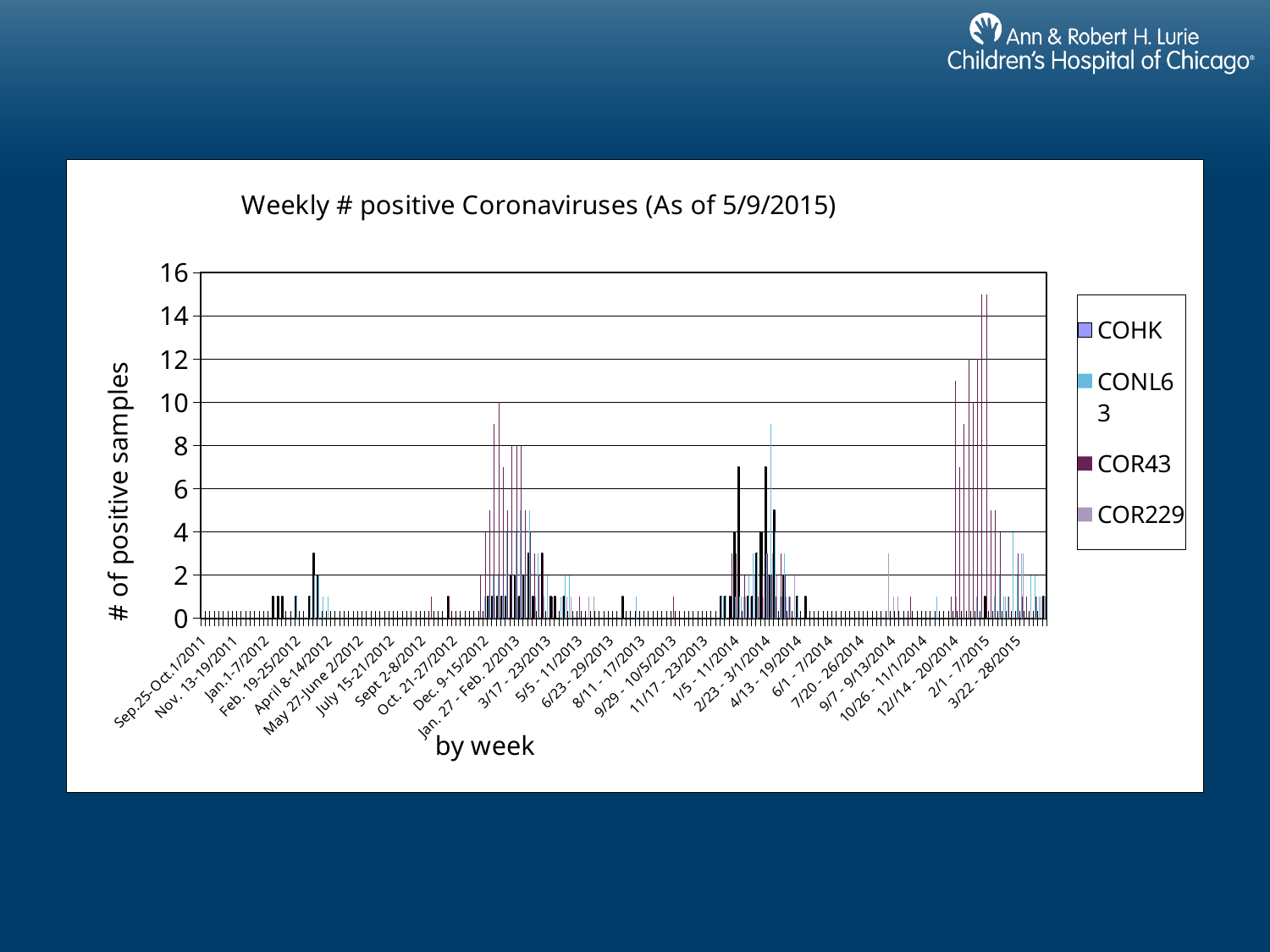
Is the tallest bar in the chart greater or less than 16? less Is the tallest bar in the cluster around 1/5 - 11/2014 to 2/23 - 3/1/2014 greater or less than 10? less What kind of chart is shown on the slide? bar chart What is the label on the vertical axis of the chart? # of positive samples Which period has taller bars: around 2/1 - 7/2015 or around 6/1 - 7/2014? around 2/1 - 7/2015 Is the tallest bar in the chart greater or less than 14? greater How many series does the legend list? 4 What is the maximum value shown on the vertical axis? 16 What is the title of the chart? Weekly # positive Coronaviruses (As of 5/9/2015)